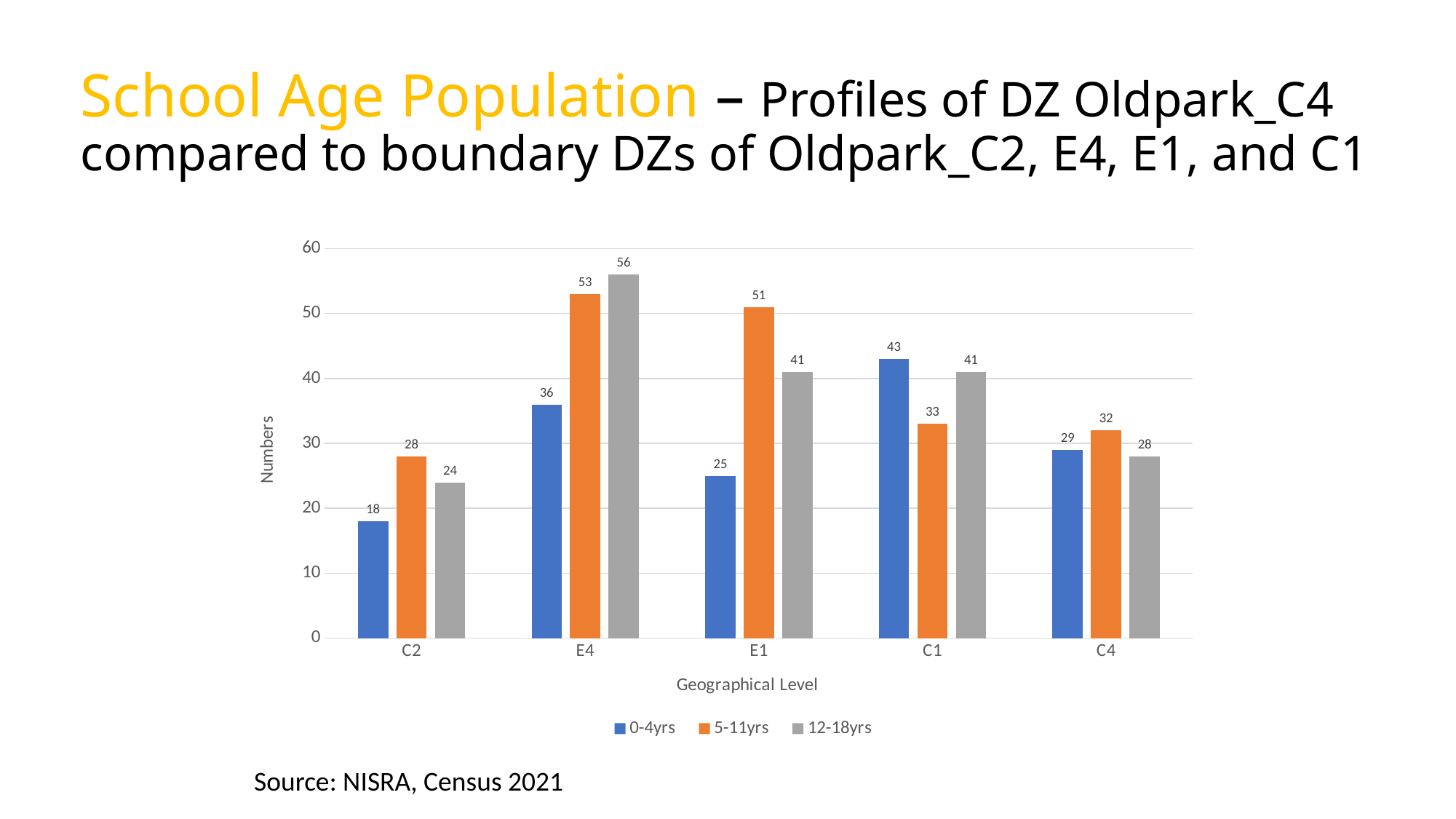
How many geographical levels are shown on the x axis? 5 How many series does the legend list? 3 Which geographical level has the lowest value for the 12-18yrs series? C2 Which is larger: the 0-4yrs value at C1 or the 12-18yrs value at C1? 0-4yrs value at C1 What is the label of the y axis? Numbers Which geographical level has the highest value for the 0-4yrs series? C1 What is the value for the 12-18yrs series at E4? 56 What kind of chart is shown on the slide? Bar chart What is the value for the 5-11yrs series at E1? 51 What is the value for the 0-4yrs series at C2? 18 Is the value for the 12-18yrs series at E1 greater or less than 30? greater What is the difference between the 5-11yrs value at E4 and the 5-11yrs value at C4? 21